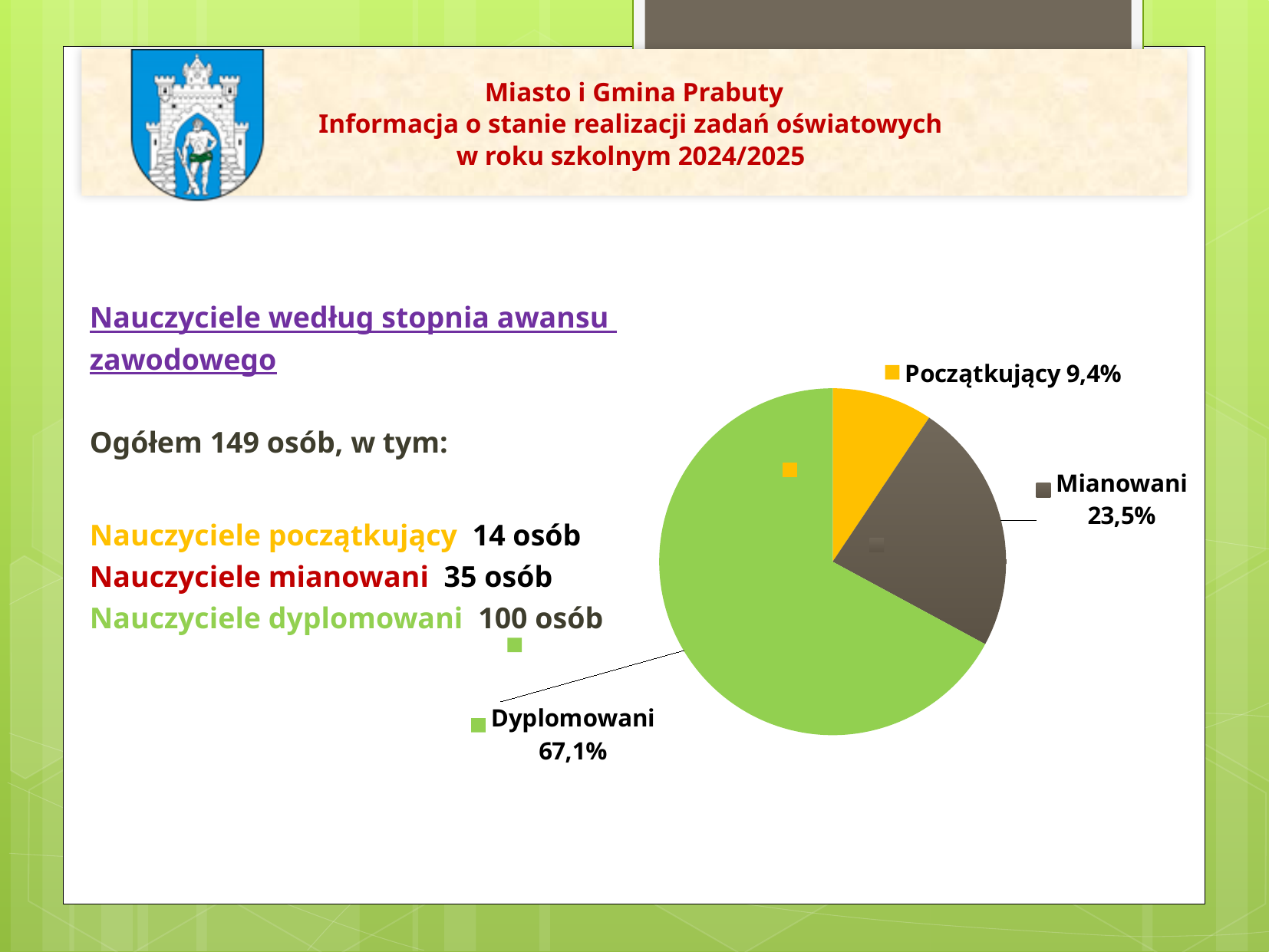
Which category has the largest slice of the pie? Dyplomowani What share of the pie does the Dyplomowani slice represent? 67,1% What share of the pie does the Mianowani slice represent? 23,5% Which category has the smallest slice of the pie? Początkujący What colour is the Dyplomowani slice of the pie chart? green What colour is the Początkujący slice of the pie chart? yellow What share of the pie does the Początkujący slice represent? 9,4% What is the difference in percentage points between the Mianowani and Początkujący slices? 14,1 Which slice is larger, Mianowani or Początkujący? Mianowani How many slices does the pie chart have? 3 What kind of chart is shown on the slide? pie chart What is the difference in percentage points between the Dyplomowani and Mianowani slices? 43,6